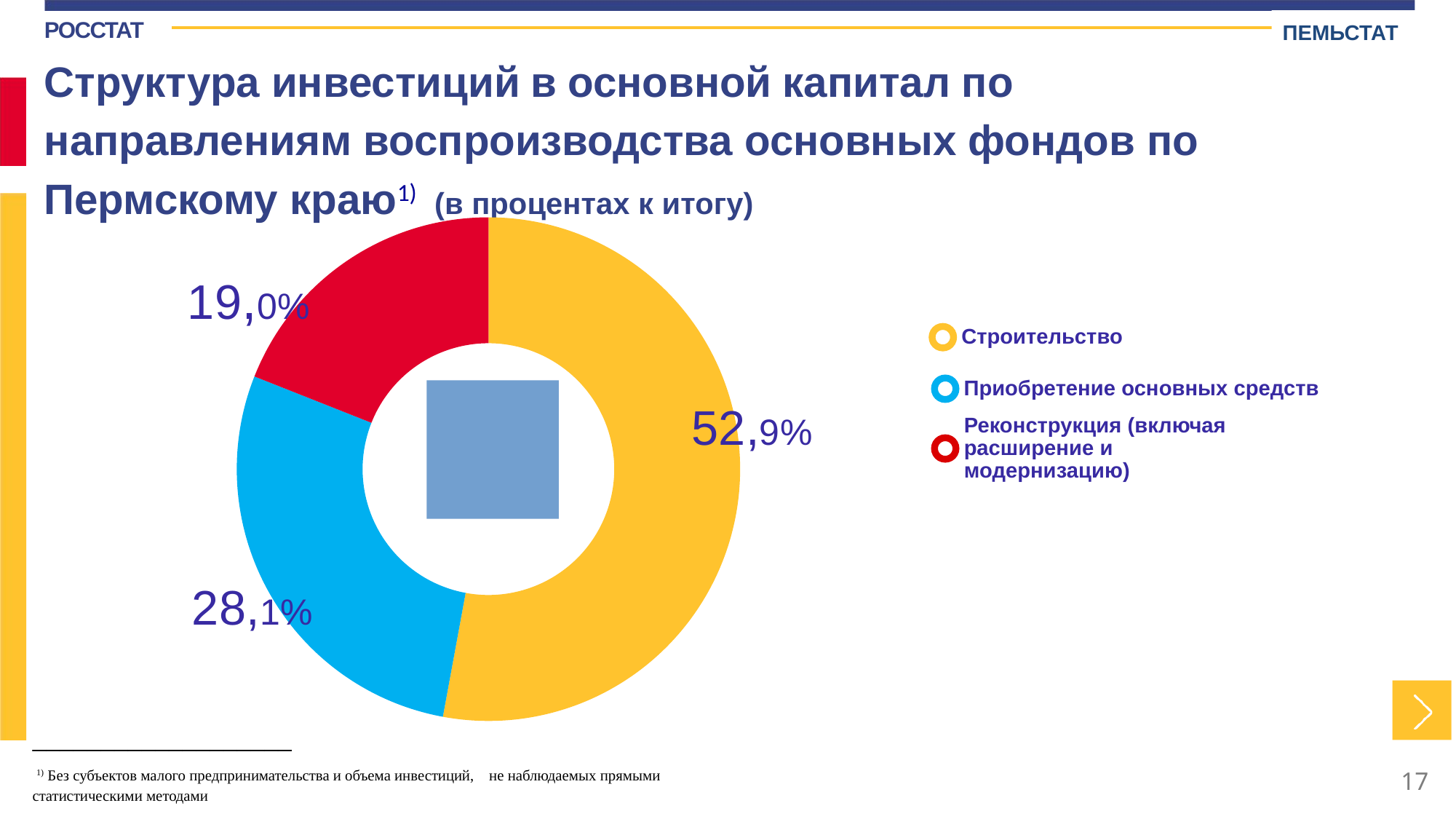
What share of investments does Строительство account for? 52,9% What kind of chart is shown on the slide? Doughnut (pie) chart Which category has the largest share of investments? Строительство What colour represents Строительство in the chart? Yellow What share of investments does Приобретение основных средств account for? 28,1% Which category has the smallest share of investments? Реконструкция (включая расширение и модернизацию) How many categories are shown in the chart? 3 Which is larger: the share of Приобретение основных средств or the share of Реконструкция? Приобретение основных средств What is the difference in percentage points between the shares of Приобретение основных средств and Реконструкция? 9,1 How many entries does the legend list? 3 What is the difference in percentage points between the shares of Строительство and Приобретение основных средств? 24,8 What share of investments does Реконструкция (включая расширение и модернизацию) account for? 19,0%